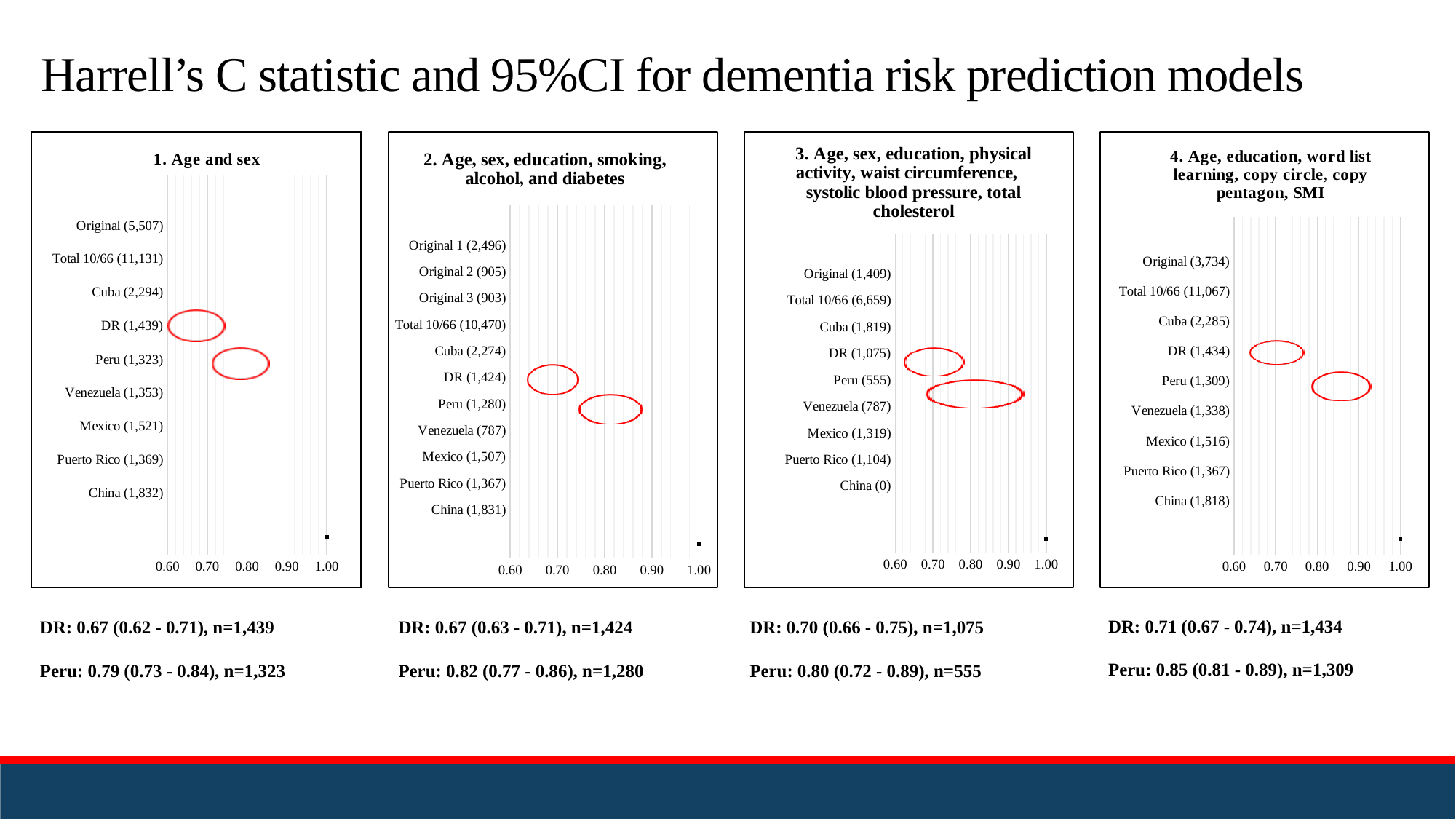
How many charts are shown on the slide? 4 In the chart titled "1. Age and sex", what is the 95% CI for Peru as printed below the chart? 0.73 - 0.84 What is the lowest value shown on the x axis of the chart titled "1. Age and sex"? 0.60 How many categories are listed on the y axis of the chart titled "2. Age, sex, education, smoking, alcohol, and diabetes"? 11 How many categories are listed on the y axis of the chart titled "1. Age and sex"? 9 In the chart titled "4. Age, education, word list learning, copy circle, copy pentagon, SMI", what is the Harrell's C statistic for Peru as printed below the chart? 0.85 In the chart titled "3. Age, sex, education, physical activity, waist circumference, systolic blood pressure, total cholesterol", what sample size is shown in the label for Peru? 555 In the chart titled "1. Age and sex", which has the higher Harrell's C statistic, DR or Peru? Peru In the chart titled "3. Age, sex, education, physical activity, waist circumference, systolic blood pressure, total cholesterol", what is the Harrell's C statistic for DR as printed below the chart? 0.70 In the chart titled "4. Age, education, word list learning, copy circle, copy pentagon, SMI", what is the difference between the Harrell's C statistic for Peru and for DR? 0.14 In the chart titled "1. Age and sex", what is the Harrell's C statistic for DR as printed below the chart? 0.67 In the chart titled "2. Age, sex, education, smoking, alcohol, and diabetes", what is the Harrell's C statistic for Peru as printed below the chart? 0.82